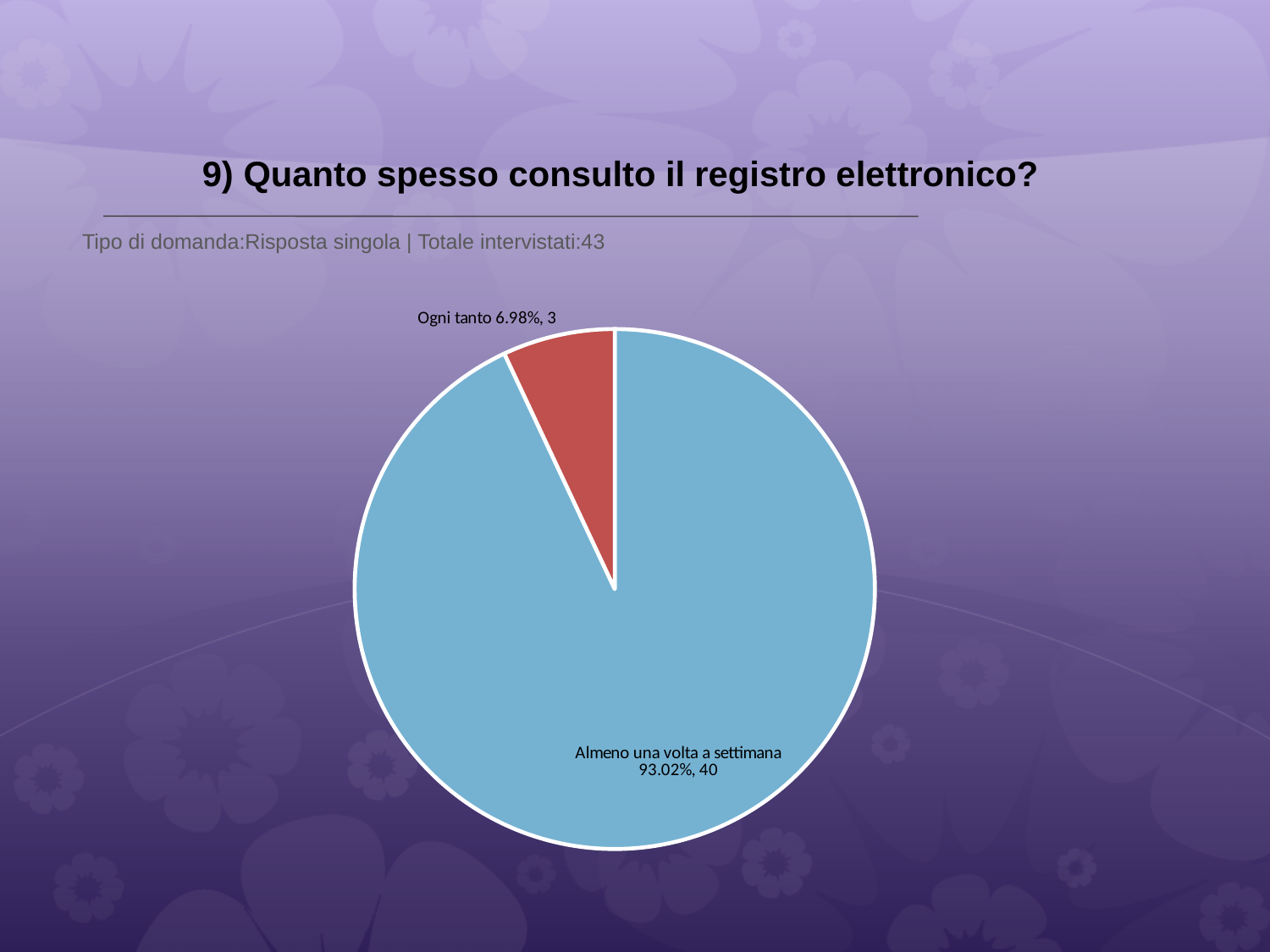
How many respondents answered "Almeno una volta a settimana"? 40 How many slices does the pie chart have? 2 Which has more respondents, "Ogni tanto" or "Almeno una volta a settimana"? Almeno una volta a settimana How many respondents answered "Ogni tanto"? 3 Which category has the largest share of the pie? Almeno una volta a settimana What colour is the "Ogni tanto" slice? red Which category has the smallest share of the pie? Ogni tanto What is the difference in number of respondents between "Almeno una volta a settimana" and "Ogni tanto"? 37 What percentage of respondents answered "Almeno una volta a settimana"? 93.02% What percentage of respondents answered "Ogni tanto"? 6.98% What kind of chart is shown on the slide? pie chart What is the total number of respondents shown in the pie chart? 43